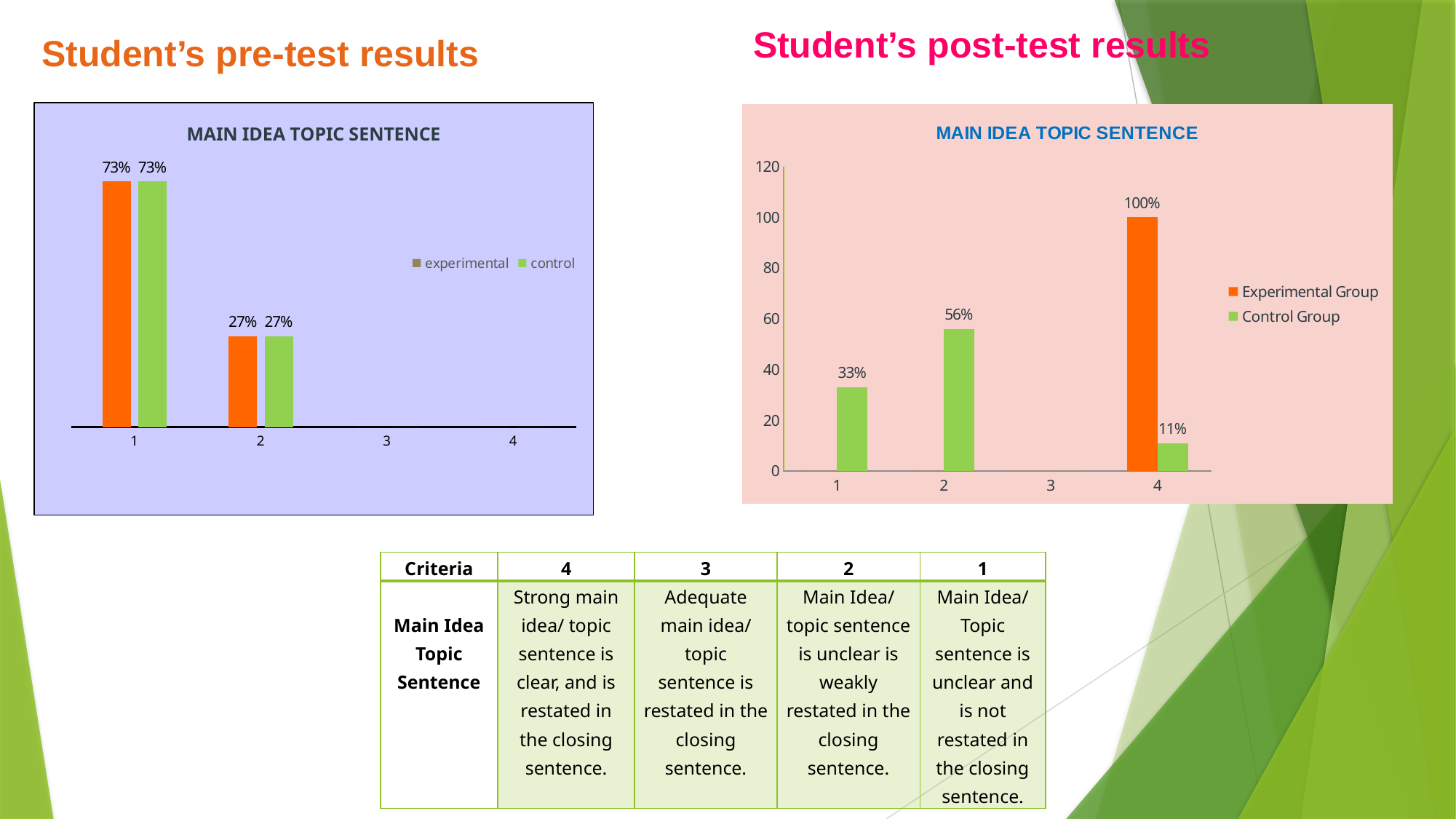
In the pre-test chart on the left, what is the difference between the experimental values at category 1 and category 2? 46% In the post-test chart on the right, which category has the highest Control Group value? 2 In the post-test chart on the right, what is the value for the Control Group at category 2? 56% In the pre-test chart on the left, what is the value for the control series at category 2? 27% What kind of chart is the pre-test chart on the left? Bar chart What is the title of the post-test chart on the right? MAIN IDEA TOPIC SENTENCE In the post-test chart on the right, what is the difference between the Experimental Group and Control Group values at category 4? 89% How many series does the legend of the post-test chart on the right list? 2 In the pre-test chart on the left, what is the value for the experimental series at category 1? 73% In the post-test chart on the right, what is the value for the Experimental Group at category 4? 100% In the post-test chart on the right, which is larger at category 4: the Experimental Group or the Control Group? Experimental Group In the post-test chart on the right, what is the value for the Control Group at category 1? 33%